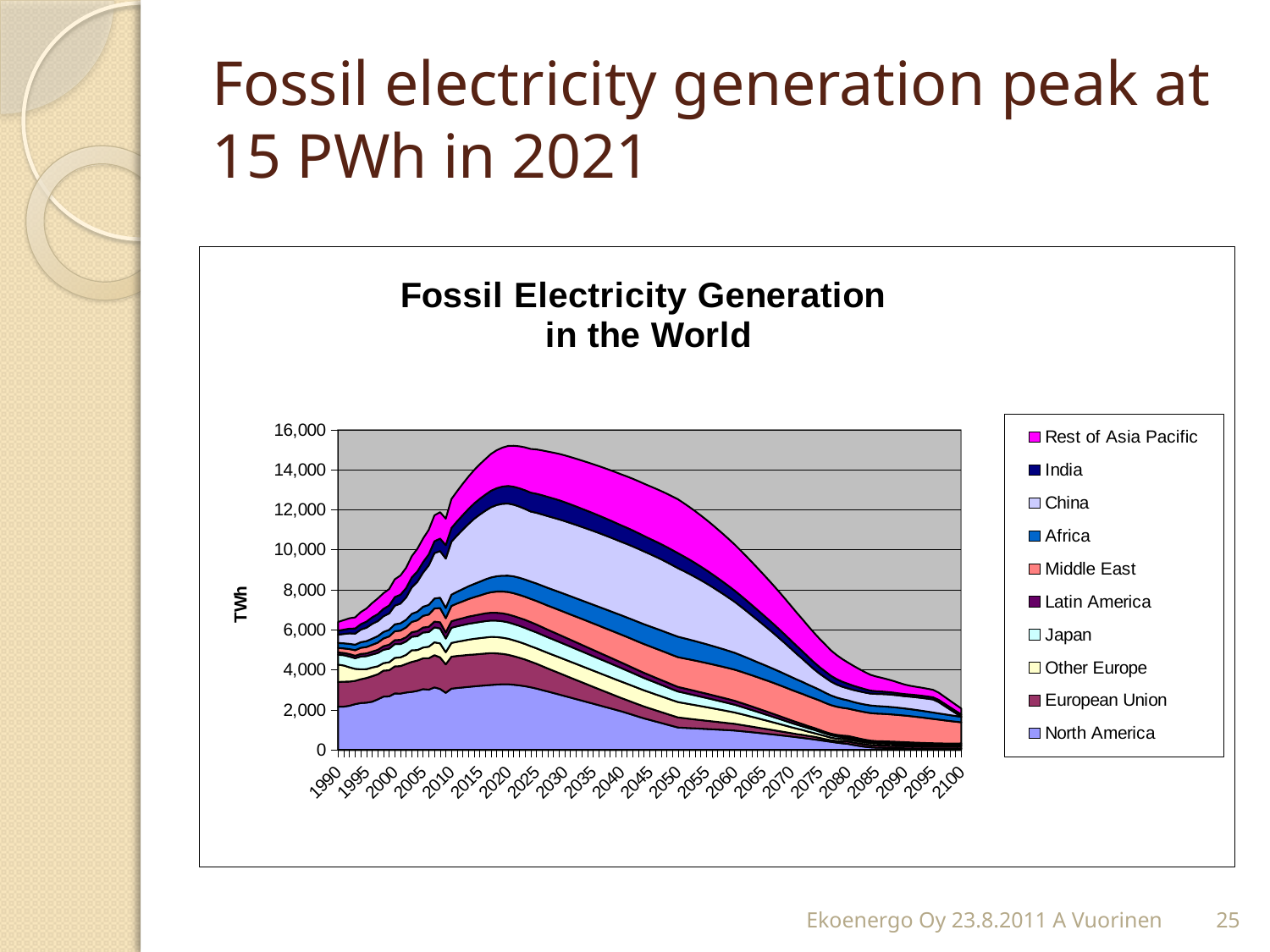
Is the total fossil electricity generation in 1990 greater or less than 8,000 TWh? less Is the total fossil electricity generation in 2100 greater or less than 4,000 TWh? less How many year labels are shown on the x axis? 23 Is the total fossil electricity generation in 2020 greater or less than 14,000 TWh? greater Which series is at the bottom of the stack in the chart? North America What kind of chart is shown on the slide? Stacked area chart Does the total fossil electricity generation rise or fall between 1990 and 2020? rise How many series does the legend list? 10 What unit is shown on the vertical axis label? TWh What is the title of the chart? Fossil Electricity Generation in the World Does the total fossil electricity generation rise or fall between 2020 and 2100? fall